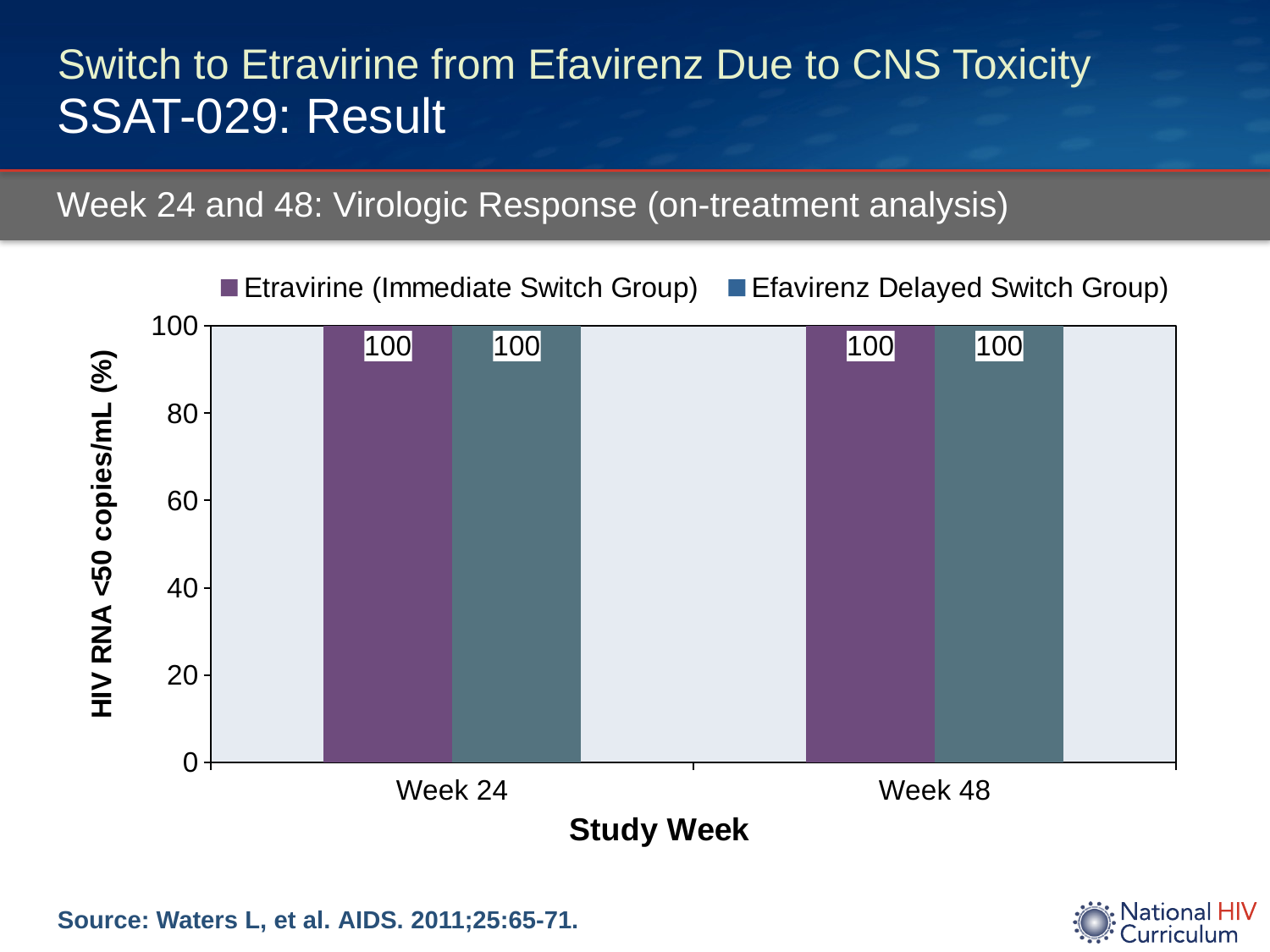
How many series does the legend list? 2 What is the difference between the Etravirine (Immediate Switch Group) and Efavirenz Delayed Switch Group values at Week 24? 0 How many study week categories are shown on the x axis? 2 What is the value for Efavirenz Delayed Switch Group at Week 48? 100 What is the value for Efavirenz Delayed Switch Group at Week 24? 100 What is the label of the y axis? HIV RNA <50 copies/mL (%) What kind of chart is shown on the slide? Bar chart Does the Efavirenz Delayed Switch Group value rise, fall, or stay the same from Week 24 to Week 48? Stays the same What is the value for Etravirine (Immediate Switch Group) at Week 48? 100 What is the difference between the Etravirine (Immediate Switch Group) value at Week 24 and at Week 48? 0 What is the value for Etravirine (Immediate Switch Group) at Week 24? 100 What is the label of the x axis? Study Week